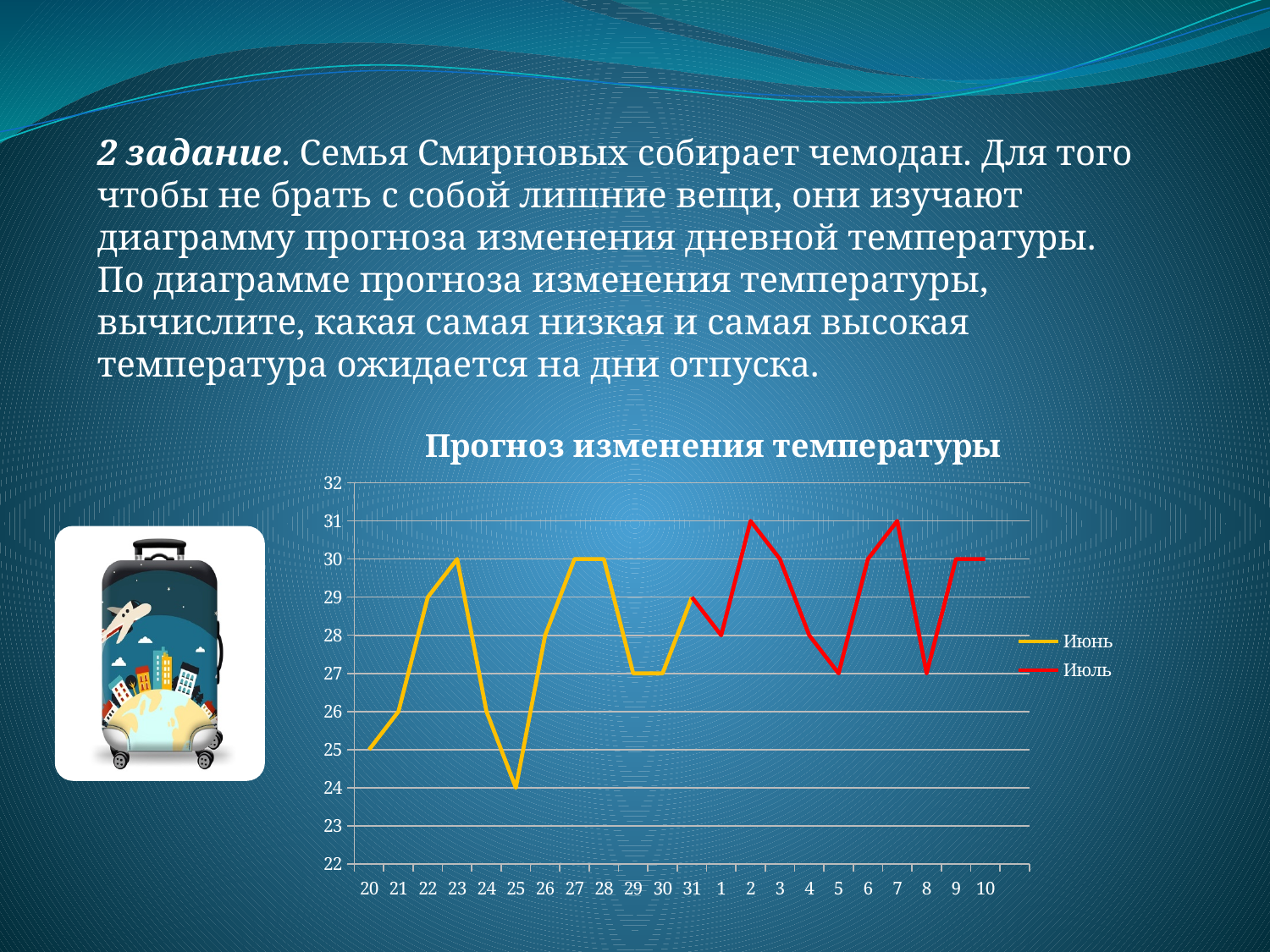
What is the highest temperature in the Июль series? 31 Which series is drawn in red? Июль What is the temperature forecast for day 20 in the Июнь series? 25 What is the title of the chart? Прогноз изменения температуры What kind of chart is shown on the slide? Line chart Is the temperature on day 22 in the Июнь series greater or less than 28? greater How many days are shown along the x axis? 22 How many series does the legend list? 2 What is the temperature forecast for day 25 in the Июнь series? 24 What is the lowest temperature in the Июнь series? 24 What is the temperature forecast for day 2 in the Июль series? 31 What is the difference between the temperature on day 2 (Июль) and day 25 (Июнь)? 7